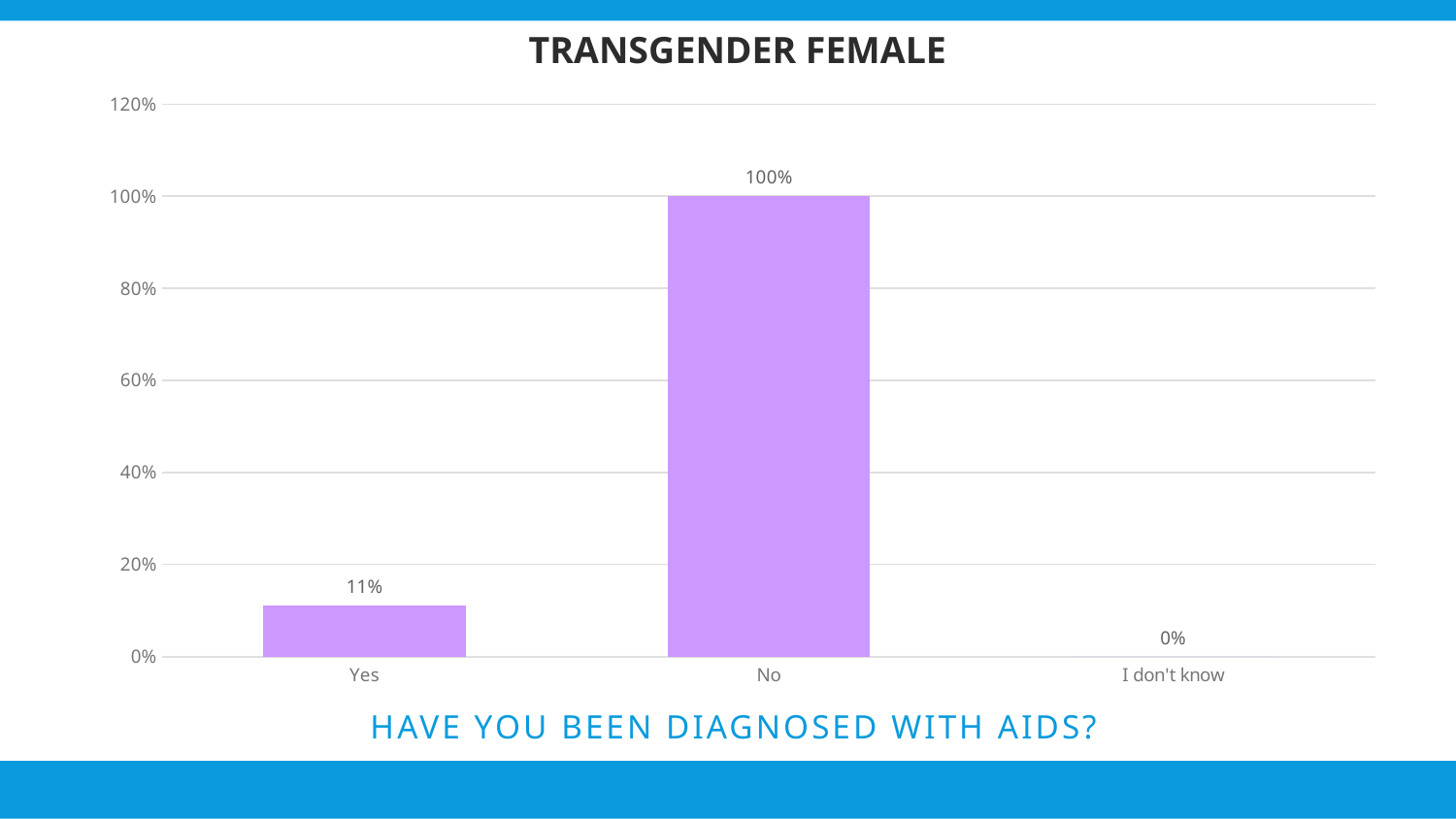
Which category has the lowest value? I don't know What question is written below the chart? HAVE YOU BEEN DIAGNOSED WITH AIDS? Which is larger, the value for "Yes" or the value for "I don't know"? Yes How many categories are shown on the x axis? 3 What is the value for "Yes"? 11% Which category has the highest value? No What is the value for "I don't know"? 0% What is the value for "No"? 100% Is the value for "Yes" greater or less than 20%? less What is the difference between the values for "No" and "Yes"? 89% What is the title of the chart? TRANSGENDER FEMALE What kind of chart is shown on the slide? bar chart